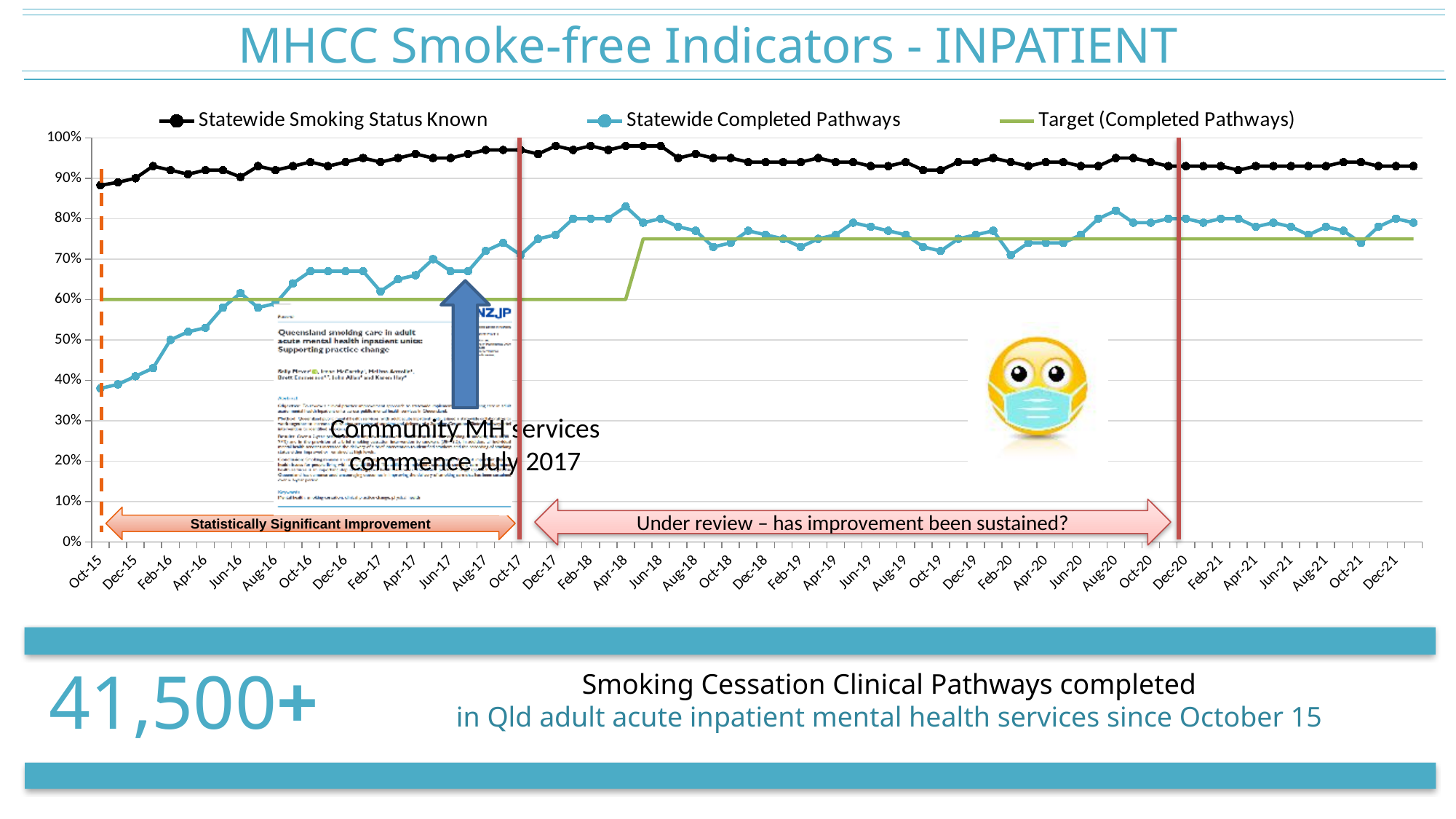
What are the three series named in the chart legend? Statewide Smoking Status Known, Statewide Completed Pathways, Target (Completed Pathways) Is the value for Statewide Smoking Status Known at Dec-21 greater or less than 80%? greater Is the value for Statewide Smoking Status Known at Oct-15 greater or less than 80%? greater What kind of chart is shown on the slide? line chart What is the first month shown on the x axis of the chart? Oct-15 At Oct-15, which series has the higher value: Statewide Smoking Status Known or Statewide Completed Pathways? Statewide Smoking Status Known At which month does the Statewide Completed Pathways line reach its lowest value? Oct-15 Is the value for Statewide Completed Pathways at Dec-21 greater or less than 70%? greater Does the Statewide Completed Pathways line rise or fall between Oct-15 and Oct-17? rise How many series does the chart legend list? 3 What is the value of the Target (Completed Pathways) line at Oct-15? 60%